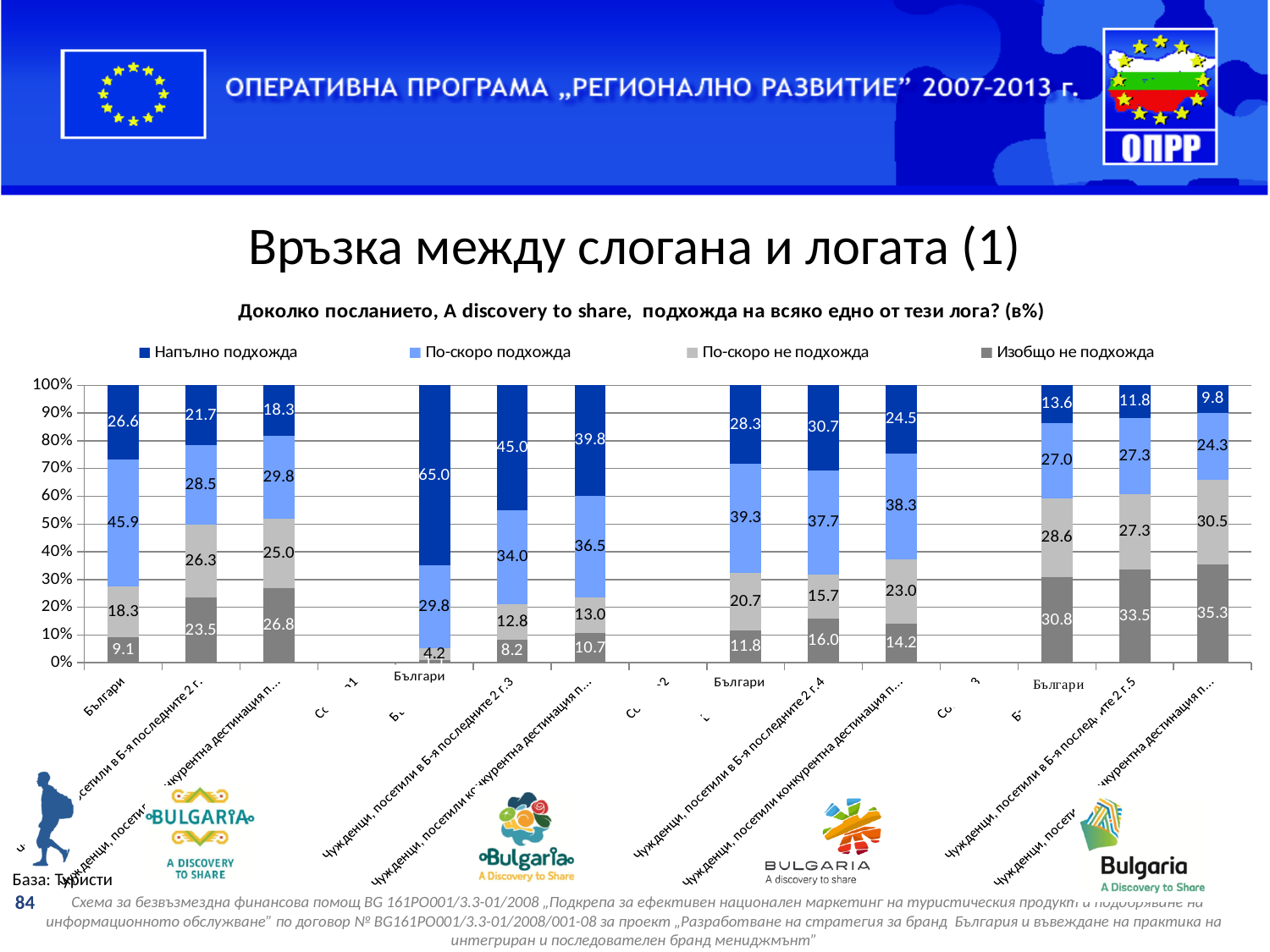
What are the four legend entries of the chart? Напълно подхожда, По-скоро подхожда, По-скоро не подхожда, Изобщо не подхожда What kind of chart is shown on the slide? Stacked bar chart How many series does the chart legend list? 4 For the leftmost bar, what is the difference between the 'По-скоро подхожда' value and the 'Напълно подхожда' value? 19.3 What is the title of the chart? Доколко посланието, A discovery to share, подхожда на всяко едно от тези лога? (в%) Which has the larger 'Изобщо не подхожда' value: the leftmost bar or the rightmost bar? The rightmost bar What is the lowest 'Напълно подхожда' value shown in the chart? 9.8 What is the 'По-скоро не подхожда' value for the leftmost bar? 18.3 How many stacked bars are plotted in the chart? 12 What is the 'Изобщо не подхожда' value for the rightmost bar? 35.3 What is the 'Напълно подхожда' value for the leftmost bar? 26.6 What is the highest 'Напълно подхожда' value shown in the chart? 65.0